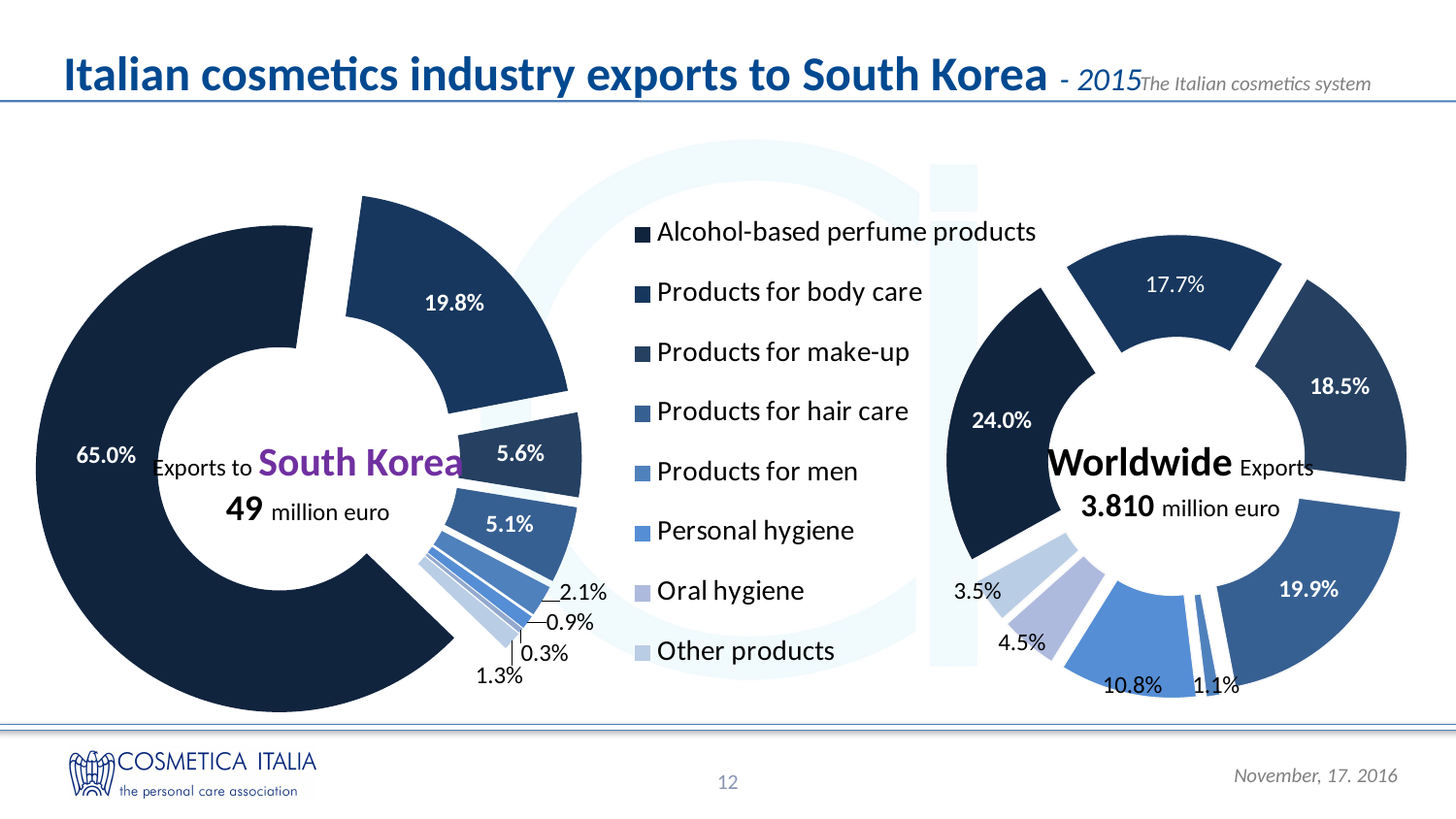
In the Exports to South Korea chart, what is the smallest share shown? 0.3% In the Worldwide Exports chart, which is larger: the 19.9% slice or the 18.5% slice? 19.9% What type of charts are shown on the slide? Doughnut (pie) charts How many categories does the legend list? 8 In the Exports to South Korea chart, what is the difference between the 65.0% slice and the 19.8% slice? 45.2 percentage points In the Worldwide Exports chart, what is the difference between the 24.0% slice and the 17.7% slice? 6.3 percentage points What is the total value of Worldwide Exports shown in the right chart? 3.810 million euro In the Exports to South Korea chart, which is larger: the 5.6% slice or the 5.1% slice? 5.6% What is the total value of exports to South Korea shown in the left chart? 49 million euro In the Worldwide Exports chart, what is the largest share shown? 24.0% In the Exports to South Korea chart, what is the largest share shown? 65.0% In the Worldwide Exports chart, what is the smallest share shown? 1.1%